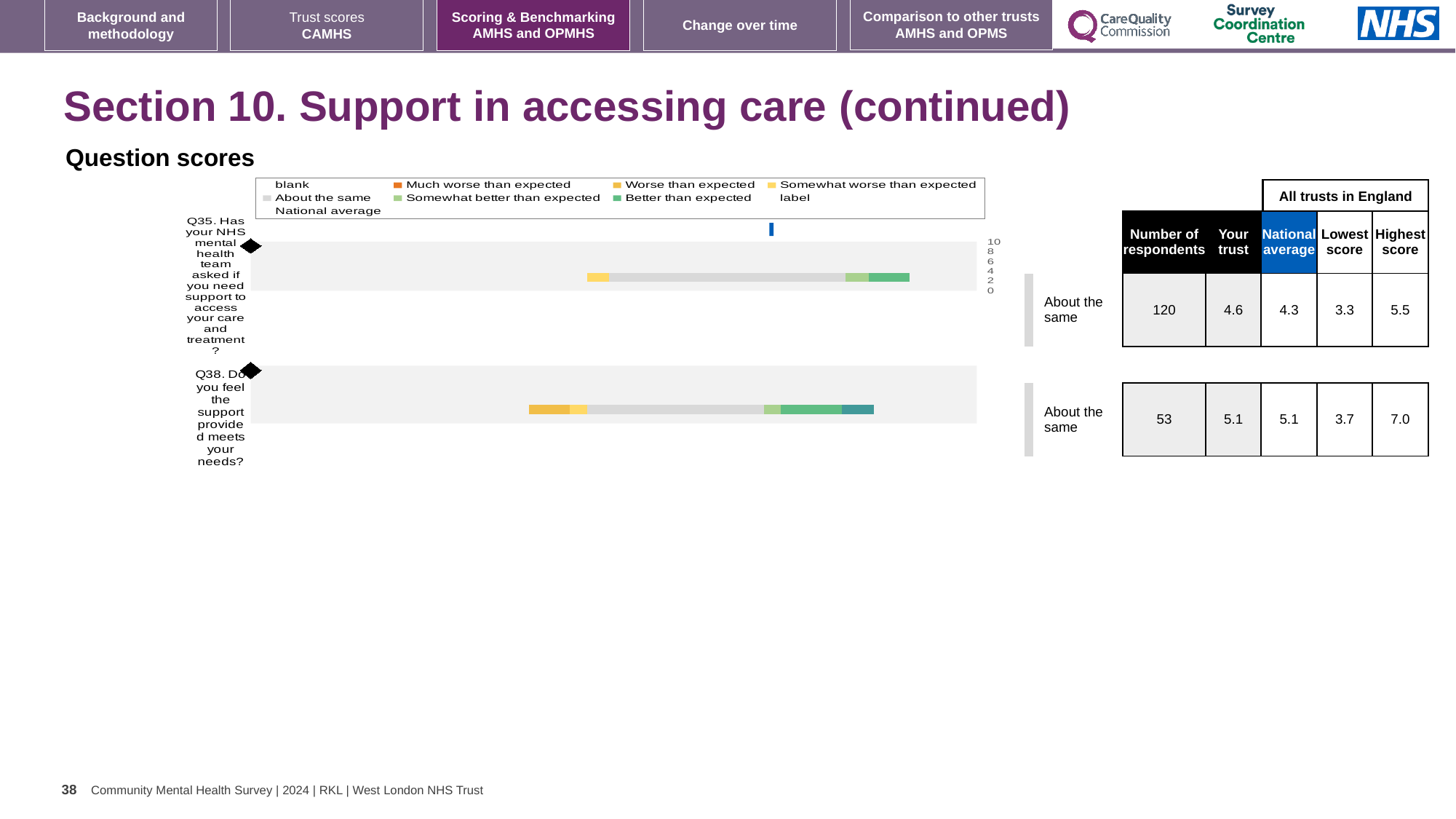
For Q35, is the 'Your trust' score or the national average higher in the table beside the chart? Your trust How many entries does the legend of the question scores chart list? 9 What kind of chart is used to show the question scores on this slide? bar chart According to the table beside the chart, what is the highest score among all trusts in England for Q38? 7.0 According to the table beside the chart, what is the national average for Q35? 4.3 According to the table beside the chart, what is the 'Your trust' score for Q38? 5.1 According to the table beside the chart, how many respondents answered Q35? 120 In the legend of the question scores chart, what colour represents 'Much worse than expected'? orange Which question has more respondents according to the table beside the chart, Q35 or Q38? Q35 How many questions (categories) are plotted in the question scores chart? 2 What is the difference between the highest score and the lowest score for Q38 in the table beside the chart? 3.3 Which question in the chart is labelled Q38? Do you feel the support provided meets your needs?